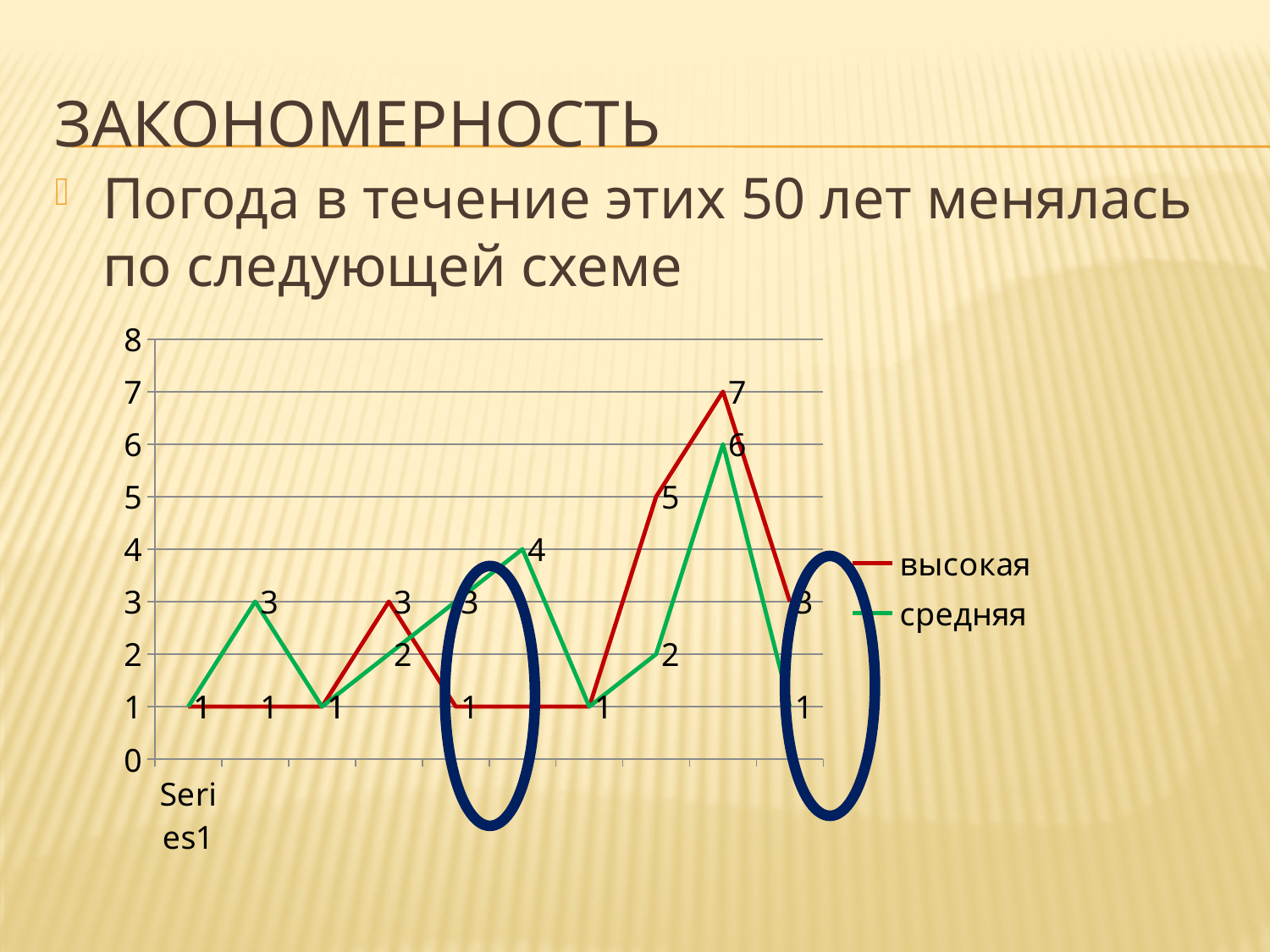
How many series does the legend list? 2 What is the lowest value reached by the series "средняя"? 1 What is the lowest value reached by the series "высокая"? 1 What is the difference between the peak value of "высокая" and the peak value of "средняя"? 1 Which colour is used for the series "высокая"? red What is the highest value reached by the series "высокая"? 7 What kind of chart is shown on the slide? line chart What is the value of the series "высокая" at the last point on the right? 3 What are the two series named in the legend? высокая and средняя What is the highest value reached by the series "средняя"? 6 Which series reaches the higher peak value, "высокая" or "средняя"? высокая What is the value of the series "средняя" at the first point (labelled Series1)? 1